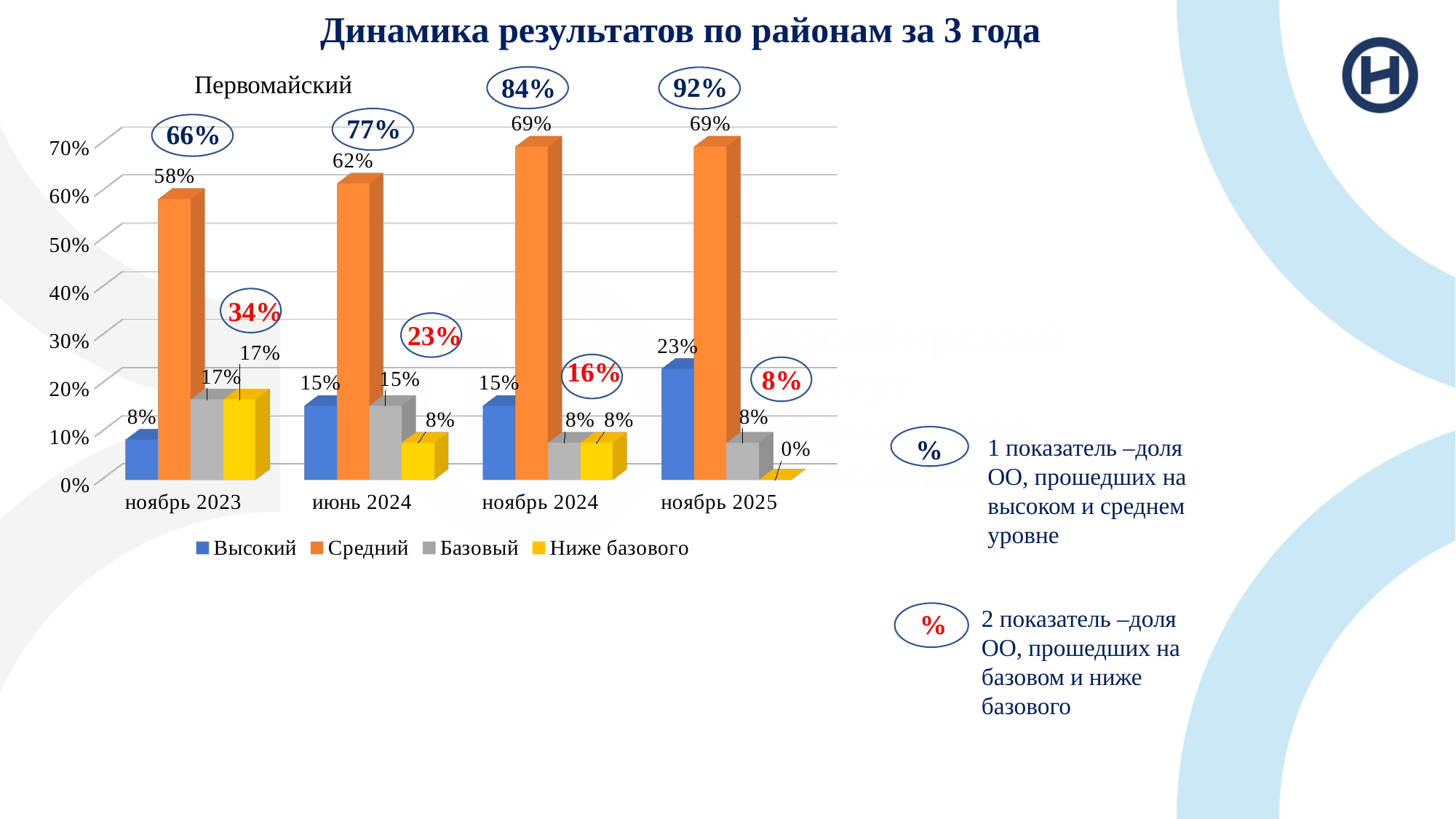
What is the difference between the Средний values for ноябрь 2024 and ноябрь 2023? 11% Which is larger in июнь 2024: Высокий or Ниже базового? Высокий What is the value for Ниже базового in ноябрь 2025? 0% What is the value for Высокий in ноябрь 2025? 23% What is the value for Средний in ноябрь 2023? 58% Does the Ниже базового series rise or fall from ноябрь 2023 to ноябрь 2025? fall How many periods are shown on the x axis? 4 How many series does the legend list? 4 In which period is the Средний series lowest? ноябрь 2023 What kind of chart is shown? bar chart What is the value for Базовый in июнь 2024? 15% In which period is the Высокий series highest? ноябрь 2025